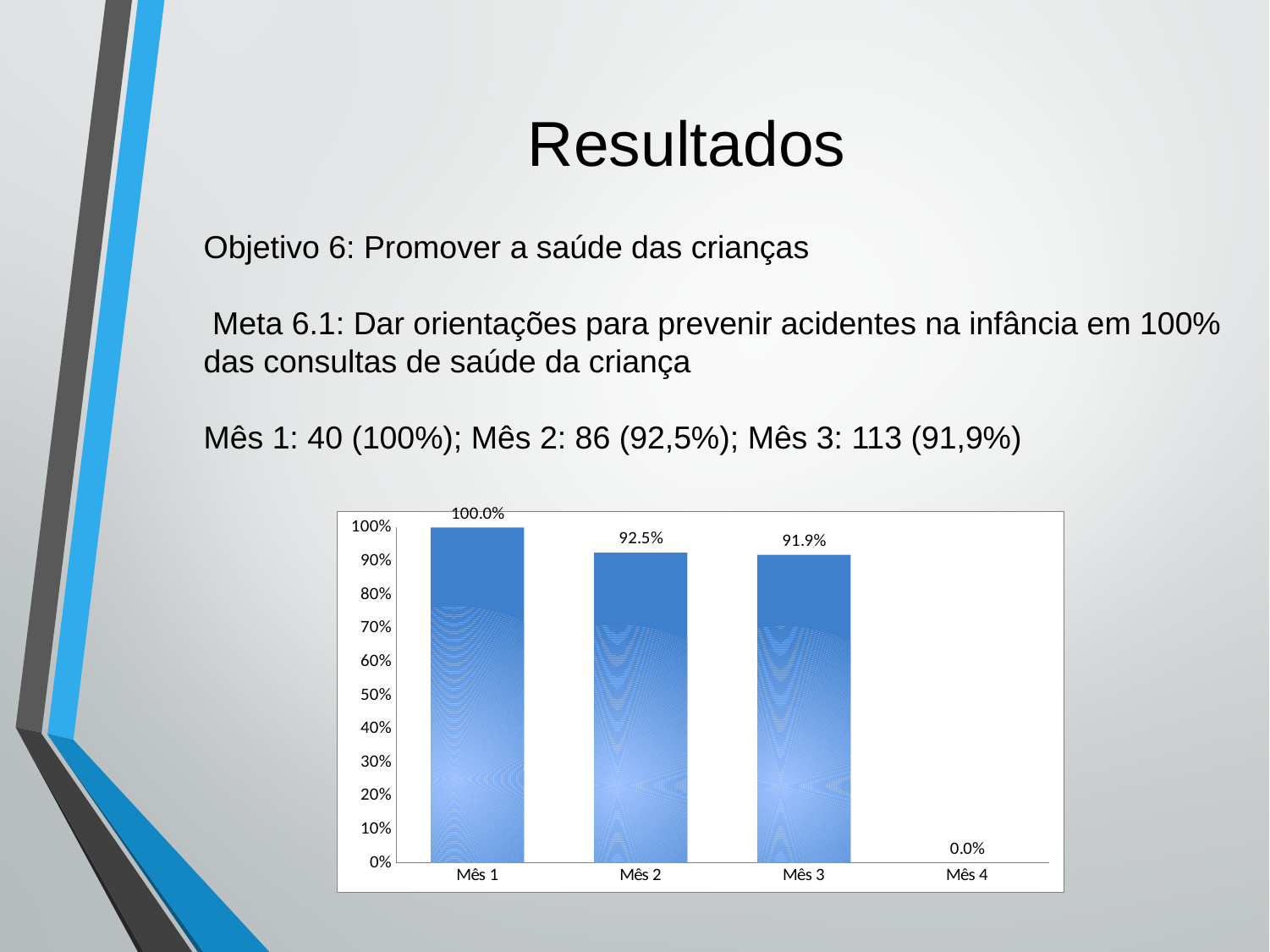
What is the value for Mês 3? 91.9% Do the values rise or fall from Mês 1 to Mês 3? fall Is the value for Mês 2 greater or less than 90%? greater What is the difference between the values for Mês 1 and Mês 2? 7.5% What is the value for Mês 1? 100.0% What kind of chart is shown on the slide? bar chart What is the value for Mês 4? 0.0% Which is larger, the value for Mês 1 or the value for Mês 3? Mês 1 Which category has the highest value? Mês 1 How many categories are shown on the x axis? 4 What is the value for Mês 2? 92.5% Which category has the lowest value? Mês 4